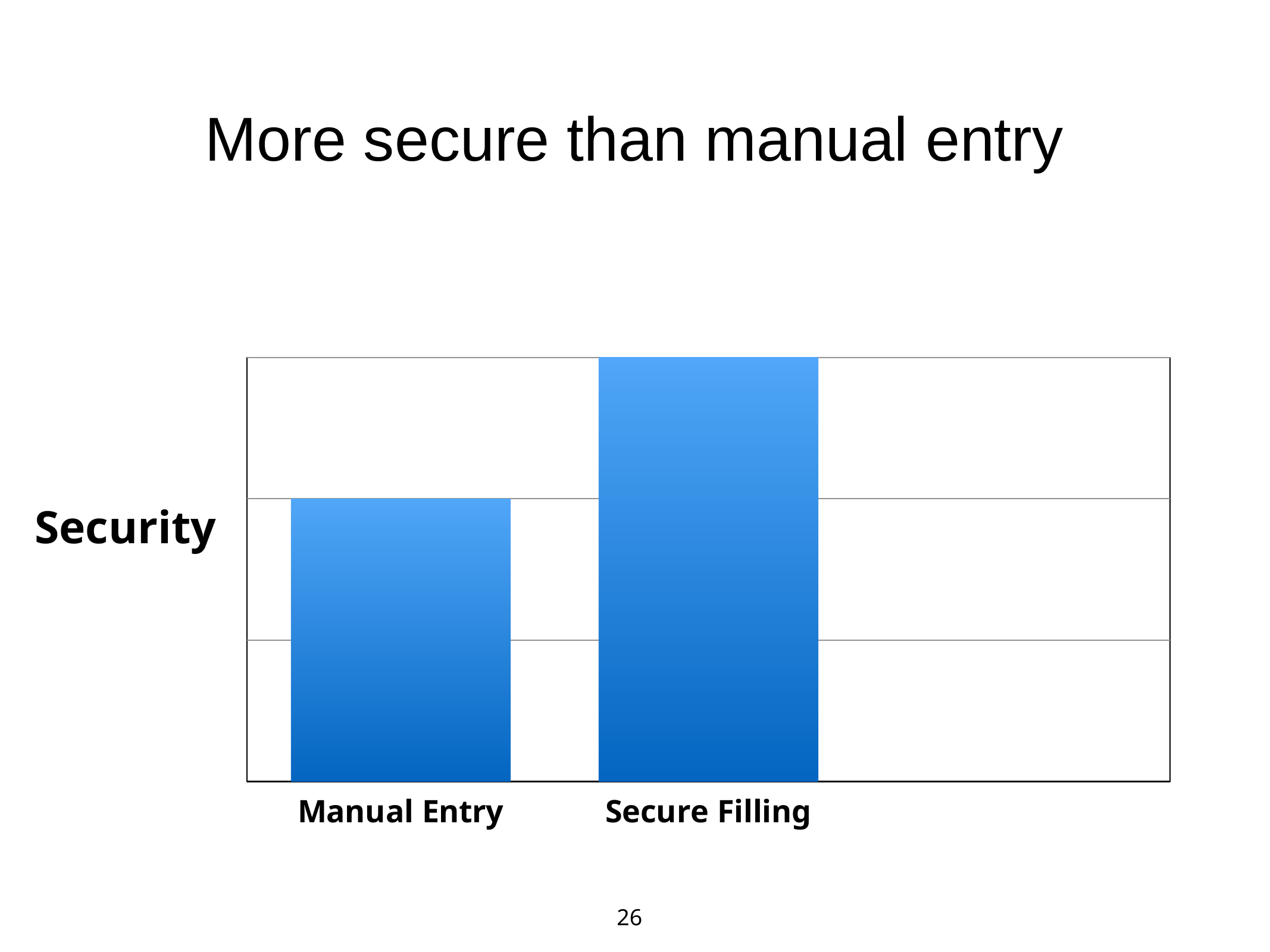
Which category has the highest bar in the chart? Secure Filling What is the label on the vertical axis of the chart? Security How many categories are shown on the x axis of the chart? 2 Which bar is taller, Manual Entry or Secure Filling? Secure Filling Which category has the lowest bar in the chart? Manual Entry Do the bar values rise or fall from left to right along the x axis? rise What is the title of the slide containing the chart? More secure than manual entry What kind of chart is shown on the slide? bar chart